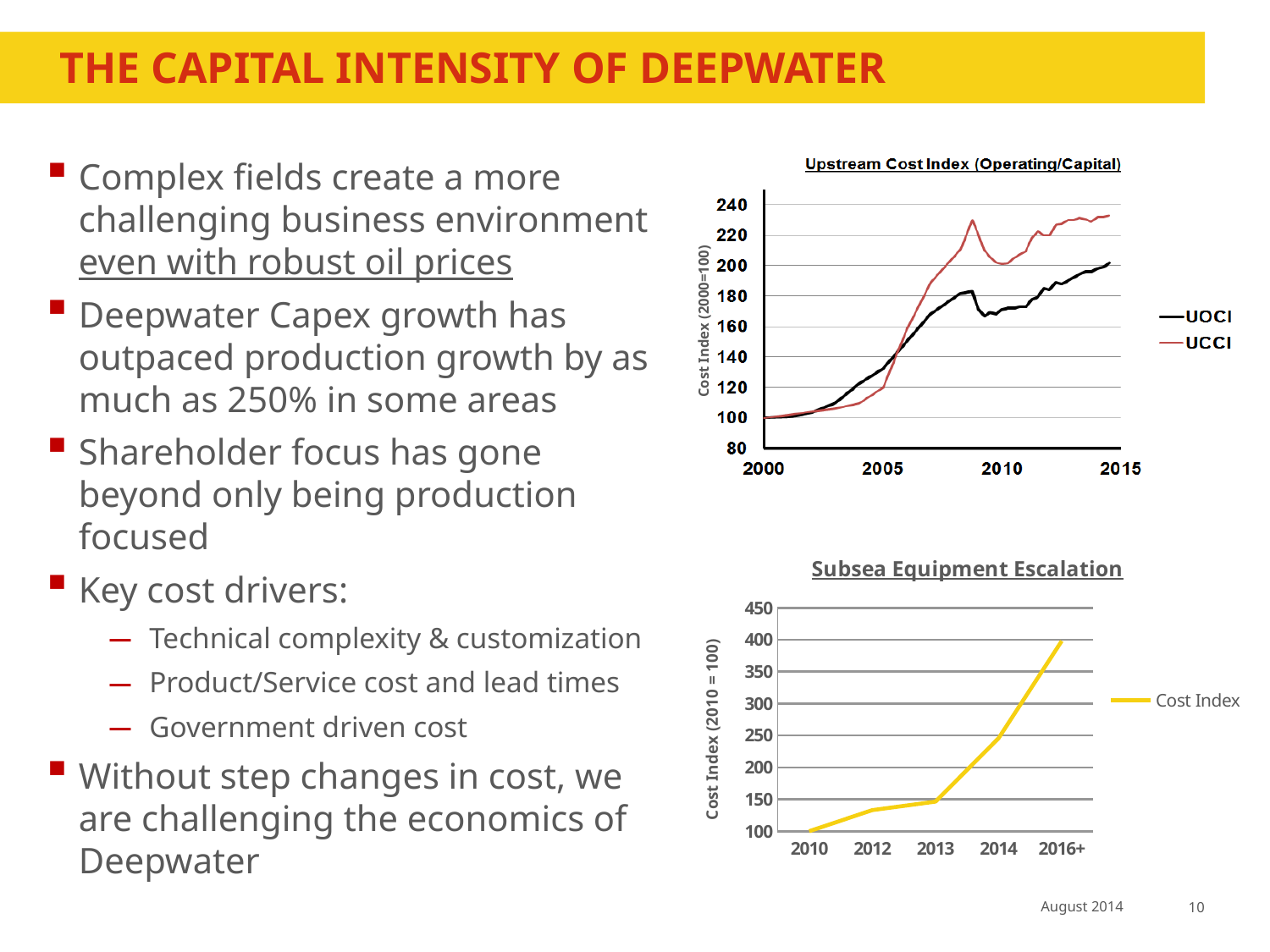
In the Subsea Equipment Escalation chart, does the Cost Index rise or fall from 2010 to 2016+? Rise How many categories are shown on the x axis of the Subsea Equipment Escalation chart? 5 In the Upstream Cost Index (Operating/Capital) chart, what is the value of both series in 2000? 100 In the Subsea Equipment Escalation chart, is the Cost Index value for 2012 greater or less than 150? less In the Upstream Cost Index (Operating/Capital) chart, which series is higher in 2015, UOCI or UCCI? UCCI How many series does the legend of the Upstream Cost Index (Operating/Capital) chart list? 2 In the Subsea Equipment Escalation chart, what is the Cost Index value for 2010? 100 What type of chart is the Upstream Cost Index (Operating/Capital) chart? Line chart In the Upstream Cost Index (Operating/Capital) chart, is the UCCI value in 2015 greater or less than 220? greater In the Upstream Cost Index (Operating/Capital) chart, is the UOCI value in 2015 greater or less than 180? greater What is the y-axis label of the Upstream Cost Index (Operating/Capital) chart? Cost Index (2000=100)